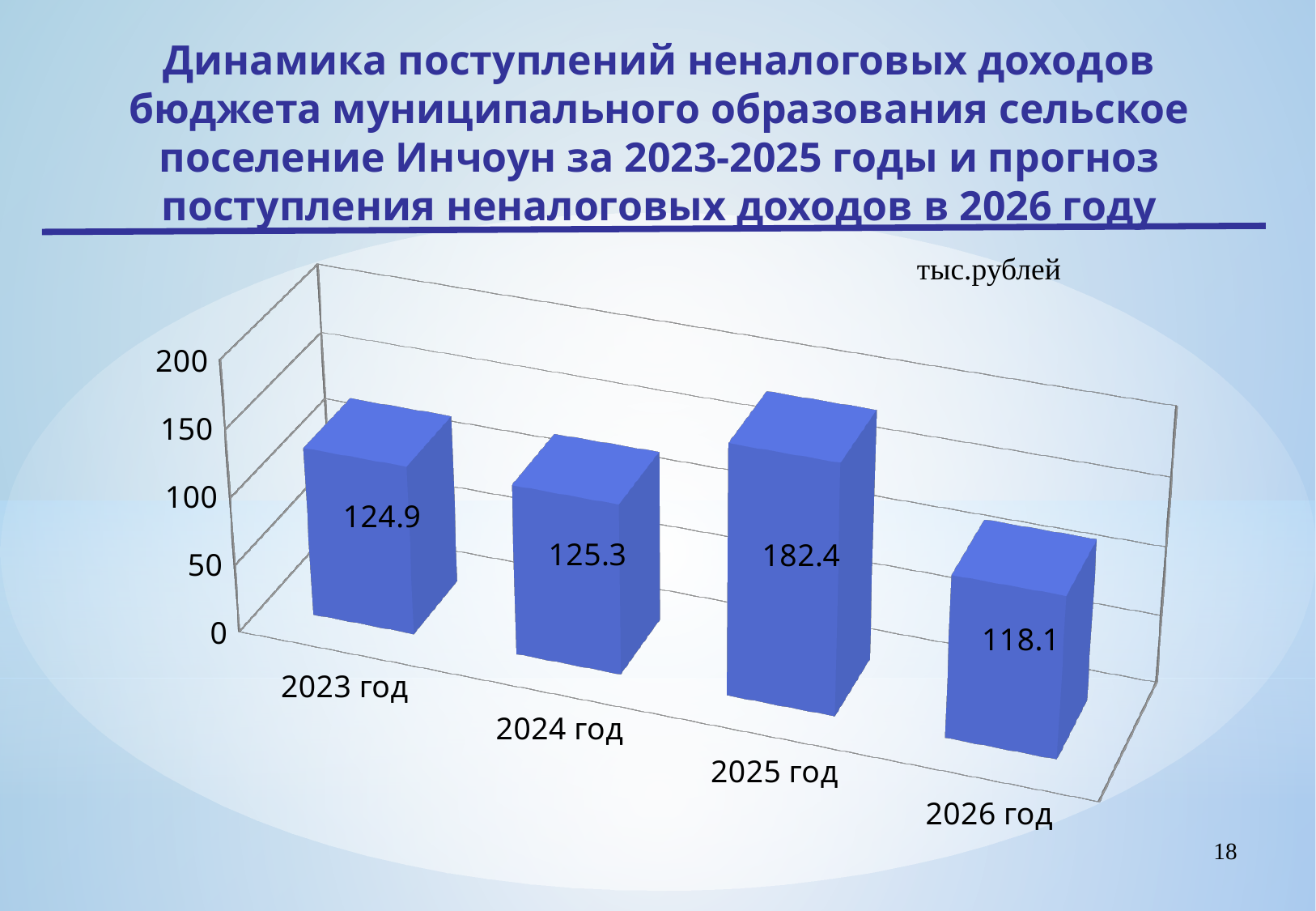
What is the difference between the values for 2024 год and 2023 год? 0.4 What kind of chart is shown on the slide? bar chart Which is larger, the value for 2025 год or the value for 2024 год? 2025 год Which year has the lowest value? 2026 год What is the difference between the values for 2025 год and 2026 год? 64.3 What is the value for 2023 год? 124.9 What is the value for 2025 год? 182.4 What is the forecast value shown for 2026 год? 118.1 Which year has the highest value? 2025 год Does the value rise or fall from 2025 год to 2026 год? fall How many years are shown on the chart? 4 Is the value for 2026 год greater or less than 150? less